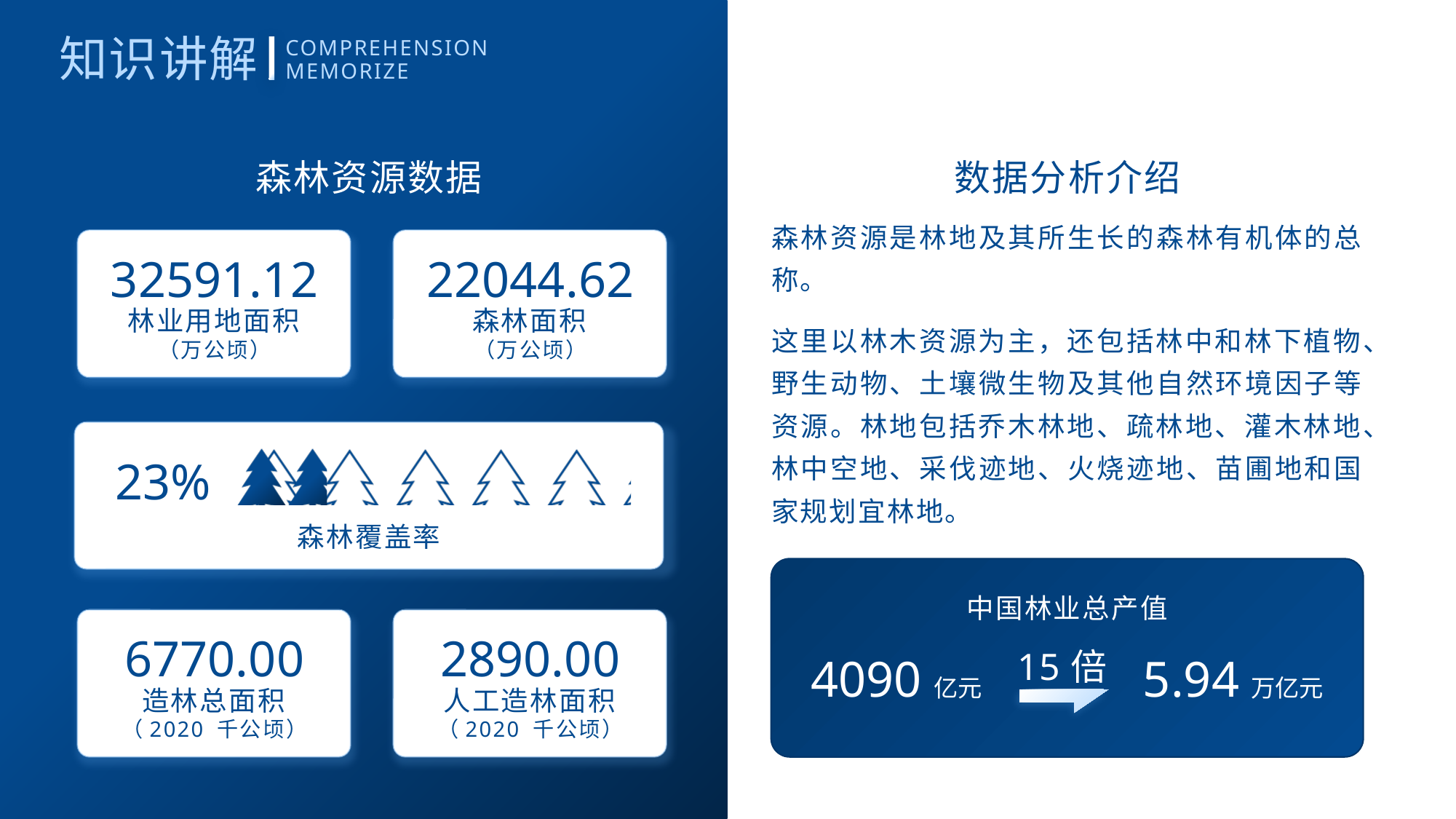
In the 森林资源数据 section, what is the value shown for 森林面积 (万公顷)? 22044.62 In the 森林资源数据 section, what is the value shown for 人工造林面积 (2020 千公顷)? 2890.00 In the 森林资源数据 section, which is larger, 林业用地面积 or 森林面积? 林业用地面积 In the 森林资源数据 section, what is the difference between 造林总面积 and 人工造林面积 (千公顷)? 3880.00 In the 中国林业总产值 box, what multiplier is shown on the arrow between the two values? 15 倍 In the 森林资源数据 section, what is the value shown for 林业用地面积 (万公顷)? 32591.12 In the 森林资源数据 section, what is the value shown for 造林总面积 (2020 千公顷)? 6770.00 What kind of graphic is used to show 森林覆盖率 on the slide? A pictograph of tree icons In the 森林资源数据 section, what percentage is shown for 森林覆盖率? 23% In the 森林资源数据 section, what is the difference between 林业用地面积 and 森林面积 (万公顷)? 10546.50 In the 中国林业总产值 box, what is the starting value shown in 亿元? 4090 In the 中国林业总产值 box, what is the ending value shown in 万亿元? 5.94